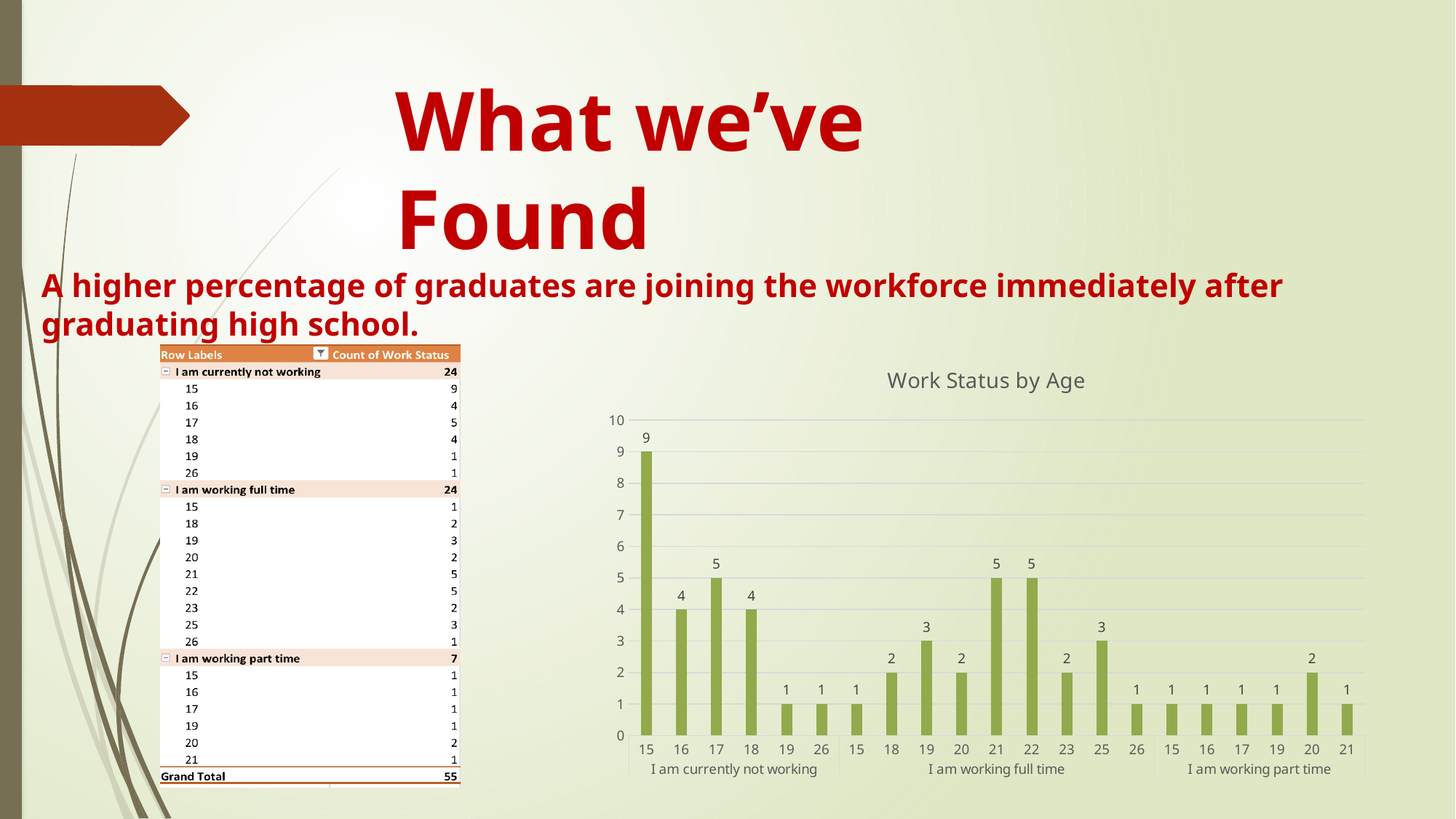
What is the title of the chart? Work Status by Age What is the value for age 20 in the 'I am working part time' group? 2 What is the value for age 15 in the 'I am currently not working' group? 9 Which is larger: the value for age 19 in the 'I am working full time' group or the value for age 19 in the 'I am currently not working' group? I am working full time What is the value for age 21 in the 'I am working full time' group? 5 What is the difference between the value for age 15 and the value for age 16 in the 'I am currently not working' group? 5 Is the value for age 15 in the 'I am currently not working' group greater or less than 5? greater What kind of chart is shown on the slide? Bar chart How many bars are plotted in the chart? 21 What is the value for age 25 in the 'I am working full time' group? 3 How many work status groups are shown along the x axis of the chart? 3 Which bar has the highest value in the chart? Age 15, I am currently not working